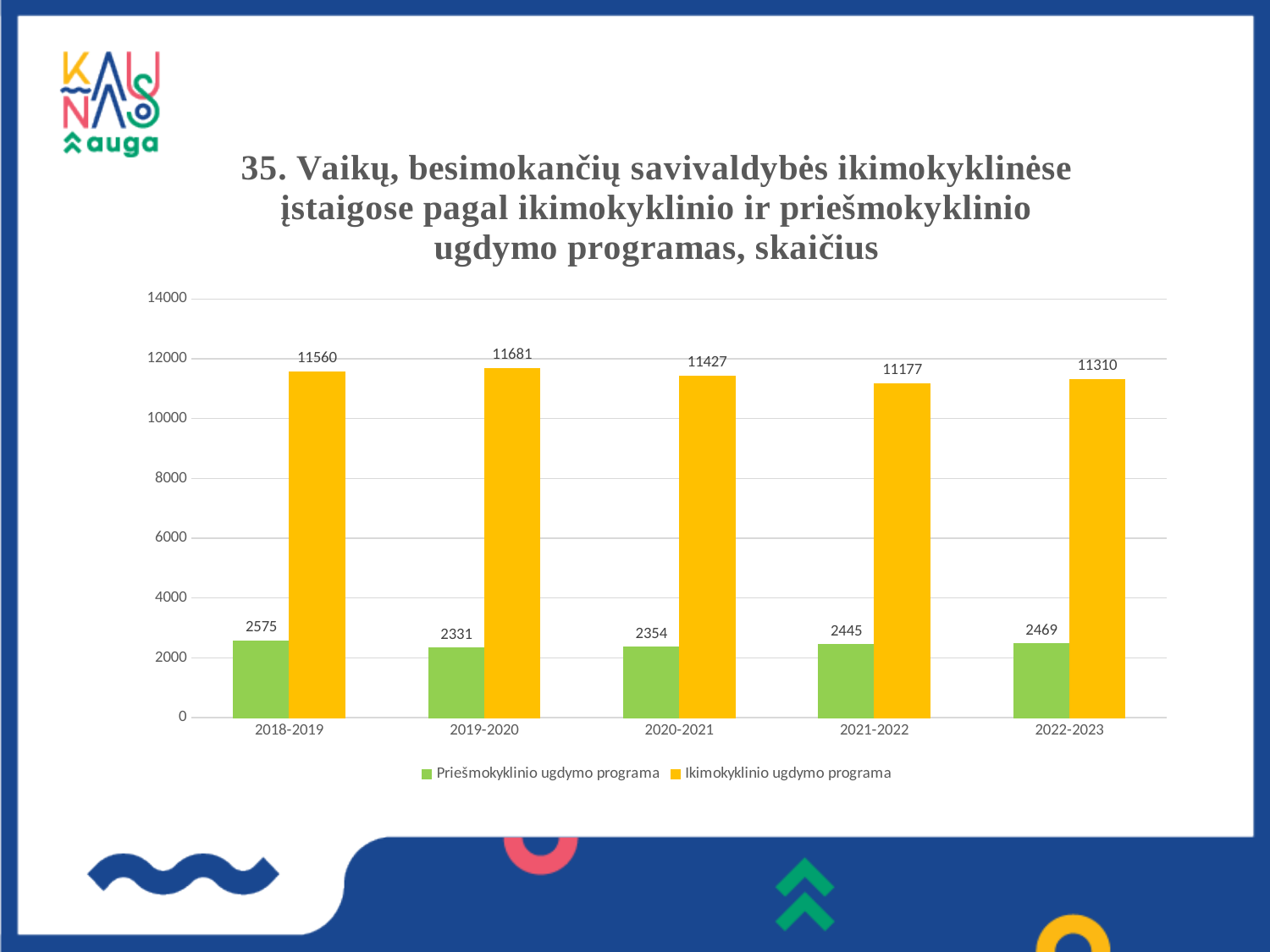
Which school year has the highest value for Ikimokyklinio ugdymo programa? 2019-2020 Which is larger: the Priešmokyklinio ugdymo programa value in 2018-2019 or in 2022-2023? 2018-2019 What colour are the bars for Ikimokyklinio ugdymo programa? yellow What is the difference between the Ikimokyklinio ugdymo programa values for 2018-2019 and 2022-2023? 250 What kind of chart is shown on the slide? bar chart Is the value for Ikimokyklinio ugdymo programa in 2021-2022 greater or less than 12000? less Does the Priešmokyklinio ugdymo programa value rise or fall from 2019-2020 to 2022-2023? rise How many school years are shown on the x axis? 5 Which school year has the lowest value for Priešmokyklinio ugdymo programa? 2019-2020 What is the value for Ikimokyklinio ugdymo programa in 2019-2020? 11681 How many series does the legend list? 2 What is the value for Priešmokyklinio ugdymo programa in 2021-2022? 2445